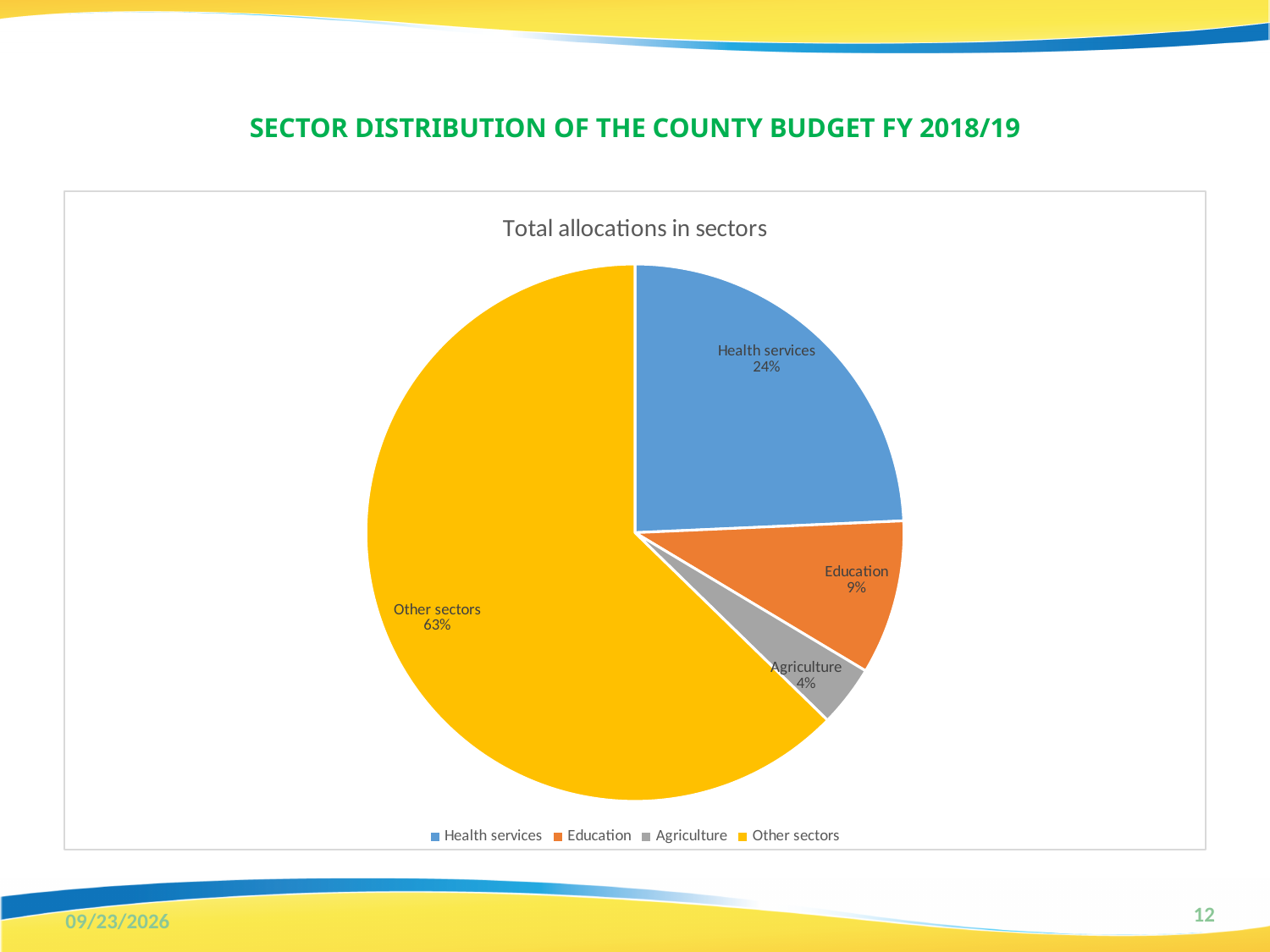
What colour is the Other sectors slice? yellow Which sector has the largest share of the budget? Other sectors Which has a larger share, Education or Agriculture? Education What share of the budget goes to Other sectors? 63% What type of chart is shown on the slide? pie chart What share of the budget goes to Education? 9% What share of the budget goes to Health services? 24% What is the difference in percentage points between Health services and Education? 15 How many sectors are shown in the pie chart? 4 Which sector has the smallest share of the budget? Agriculture What is the title of the chart? Total allocations in sectors